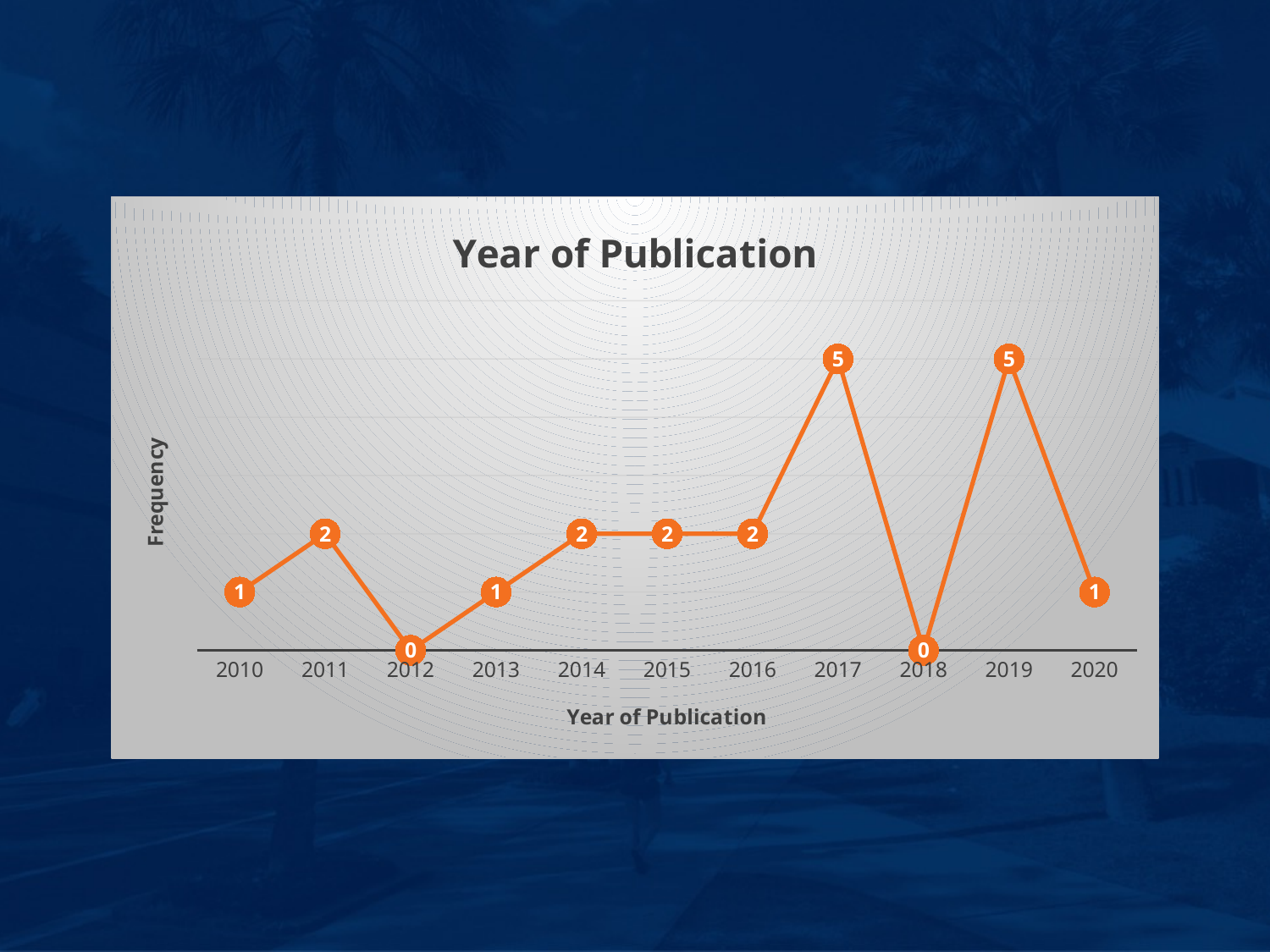
Which year has a higher frequency, 2011 or 2013? 2011 Does the frequency rise or fall from 2019 to 2020? Fall Which years have the highest frequency? 2017 and 2019 What kind of chart is shown? Line chart What is the difference between the frequency for 2019 and the frequency for 2016? 3 Which years have the lowest frequency? 2012 and 2018 What is the frequency for 2017? 5 What is the frequency for 2012? 0 How many years are plotted on the x axis? 11 What is the frequency for 2014? 2 What is the frequency for 2020? 1 What is the title of the chart? Year of Publication